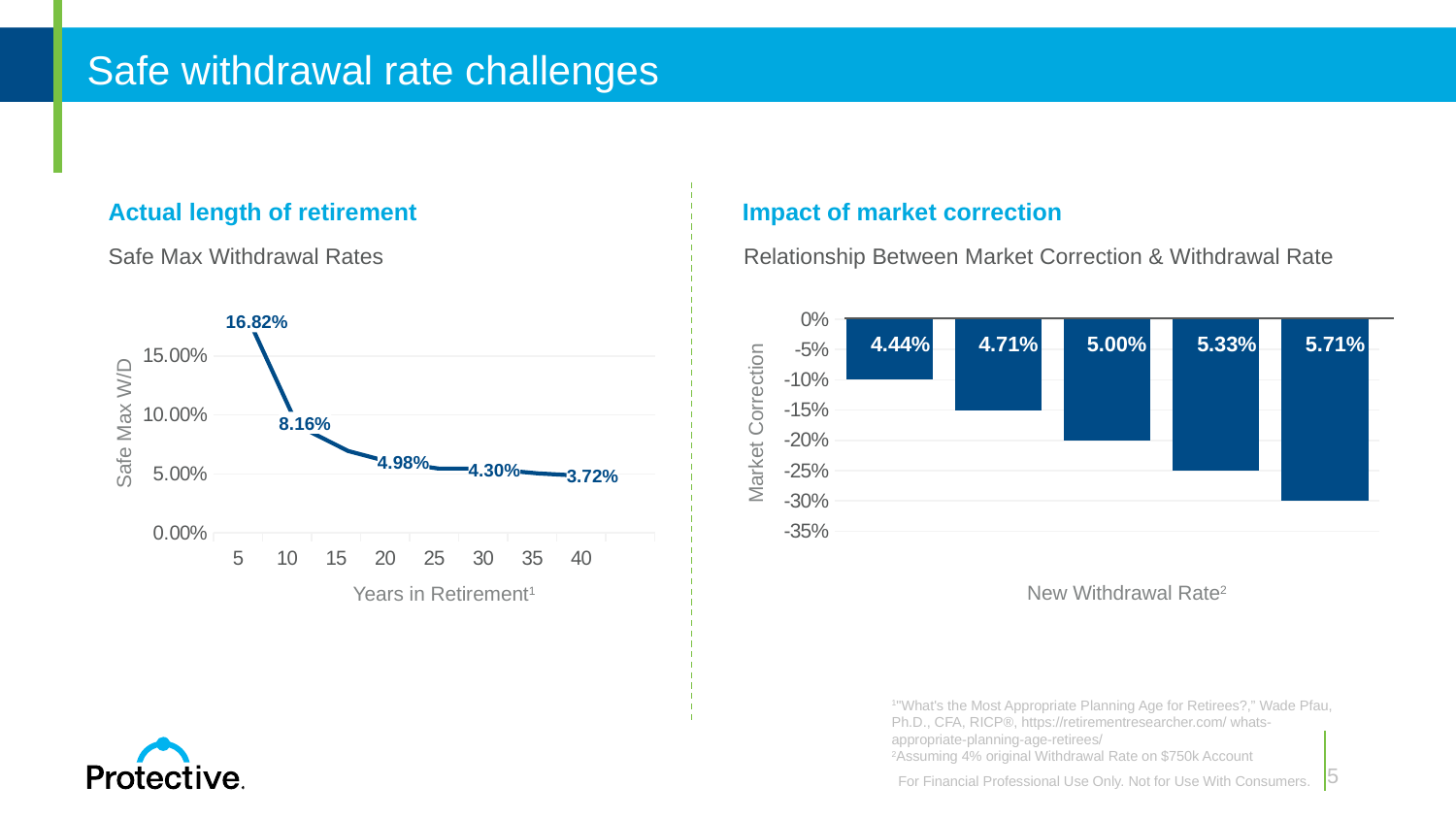
In the 'Relationship Between Market Correction & Withdrawal Rate' chart, what market correction corresponds to a new withdrawal rate of 5.00%? -20% What kind of chart is the 'Safe Max Withdrawal Rates' chart? line chart In the 'Relationship Between Market Correction & Withdrawal Rate' chart, what market correction corresponds to a new withdrawal rate of 4.44%? -10% In the 'Safe Max Withdrawal Rates' chart, what is the lowest labeled safe max withdrawal rate? 3.72% In the 'Safe Max Withdrawal Rates' chart, what is the difference between the first labeled value (16.82%) and the second labeled value (8.16%)? 8.66% In the 'Relationship Between Market Correction & Withdrawal Rate' chart, what market correction corresponds to a new withdrawal rate of 5.71%? -30% What is the x-axis title of the 'Safe Max Withdrawal Rates' chart? Years in Retirement In the 'Safe Max Withdrawal Rates' chart, do the values rise or fall as years in retirement increase? fall What kind of chart is the 'Relationship Between Market Correction & Withdrawal Rate' chart? bar chart In the 'Relationship Between Market Correction & Withdrawal Rate' chart, how many bars are plotted? 5 In the 'Relationship Between Market Correction & Withdrawal Rate' chart, which new withdrawal rate corresponds to the largest (most negative) market correction? 5.71% In the 'Safe Max Withdrawal Rates' chart, what is the highest labeled safe max withdrawal rate? 16.82%